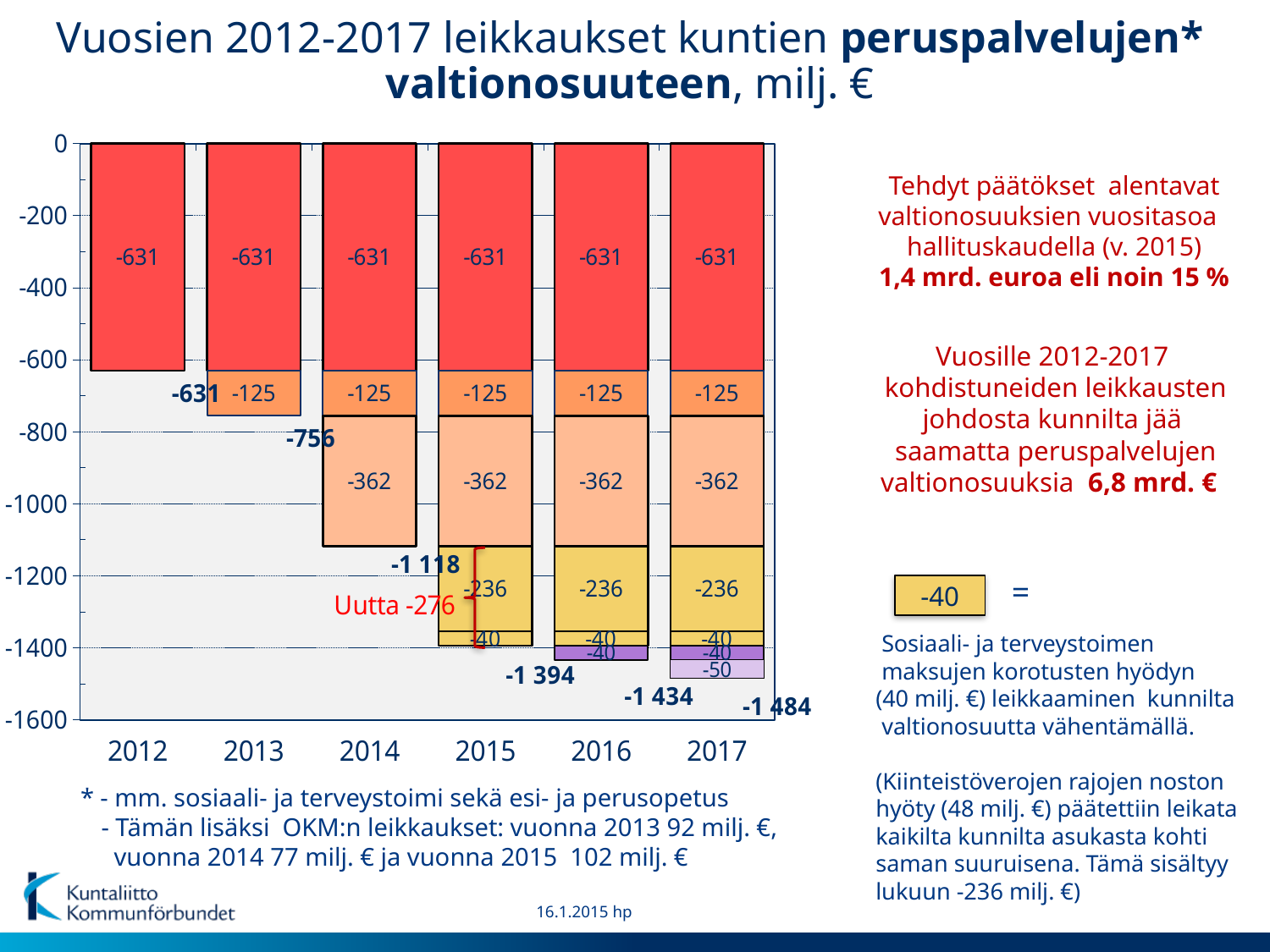
Which year has the smallest total cut? 2012 What kind of chart is shown on the slide? stacked bar chart What value is labelled in red as 'Uutta' (new) next to the 2015 bar? -276 Do the total cuts grow or shrink in magnitude from 2012 to 2017? grow How many years (categories) are shown on the x axis of the chart? 6 Which year has the largest total cut (the most negative total)? 2017 What is the value of the third segment (light orange) in the 2015 bar? -362 What is the difference between the total for 2016 (-1 434) and the total for 2015 (-1 394)? 40 What is the value of the largest (red) segment in the 2012 bar? -631 What is the total value printed for the 2013 bar? -756 What is the total value printed for the 2017 bar? -1 484 What is the total value printed for the 2014 bar? -1 118